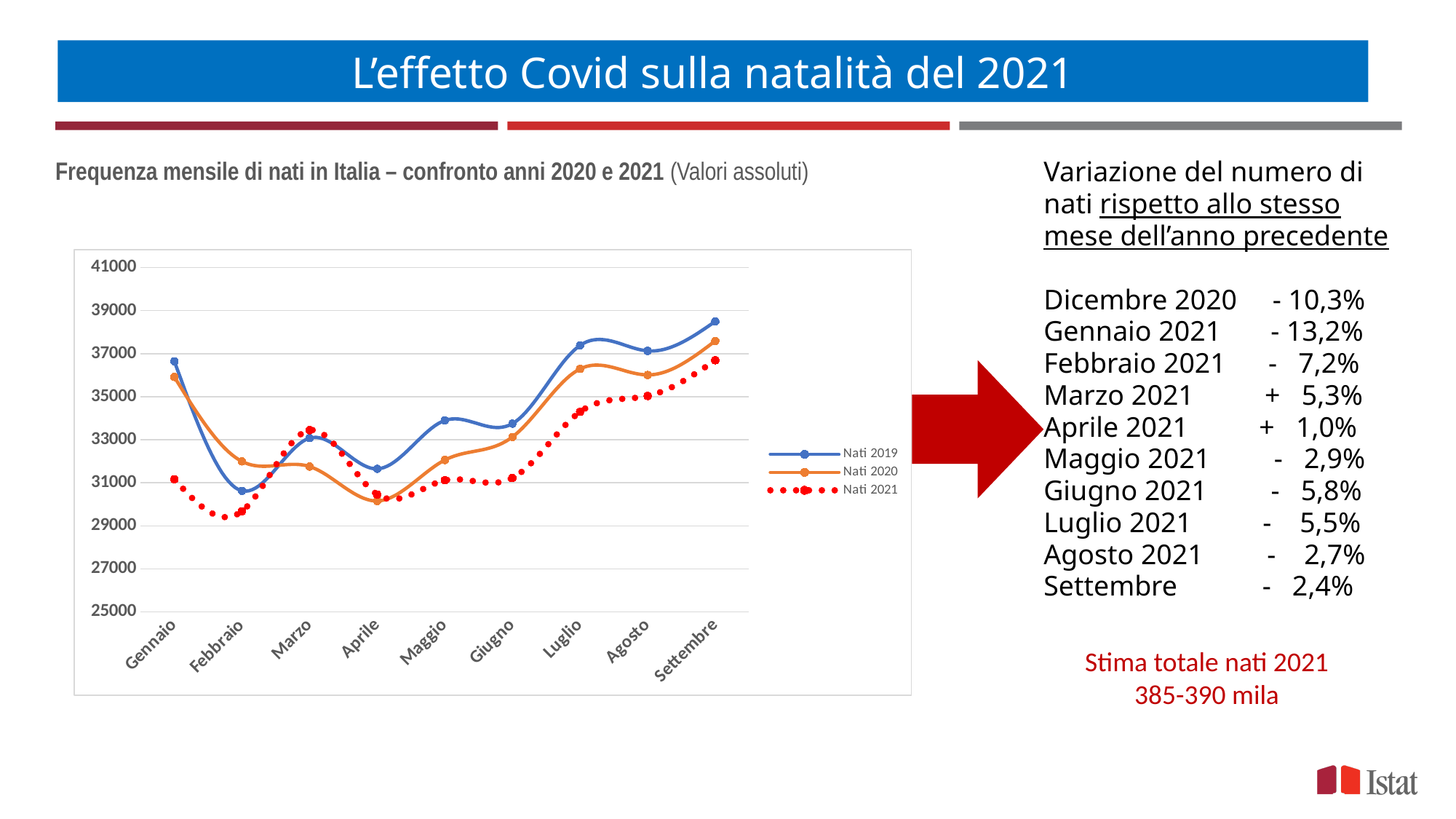
Is the value for Nati 2021 in Febbraio greater or less than 31000? less In which month does the Nati 2021 series reach its lowest value? Febbraio Does the Nati 2021 series rise or fall from Aprile to Settembre? rise In Marzo, which series has the larger value, Nati 2020 or Nati 2021? Nati 2021 In Gennaio, which series has the larger value, Nati 2019 or Nati 2021? Nati 2019 How many months are shown on the x axis of the chart? 9 What are the three series named in the chart legend? Nati 2019, Nati 2020, Nati 2021 How many series does the chart legend list? 3 Is the value for Nati 2019 in Settembre greater or less than 37000? greater Is the value for Nati 2020 in Aprile greater or less than 31000? less In which month does the Nati 2019 series reach its highest value? Settembre What kind of chart is shown on the slide? line chart